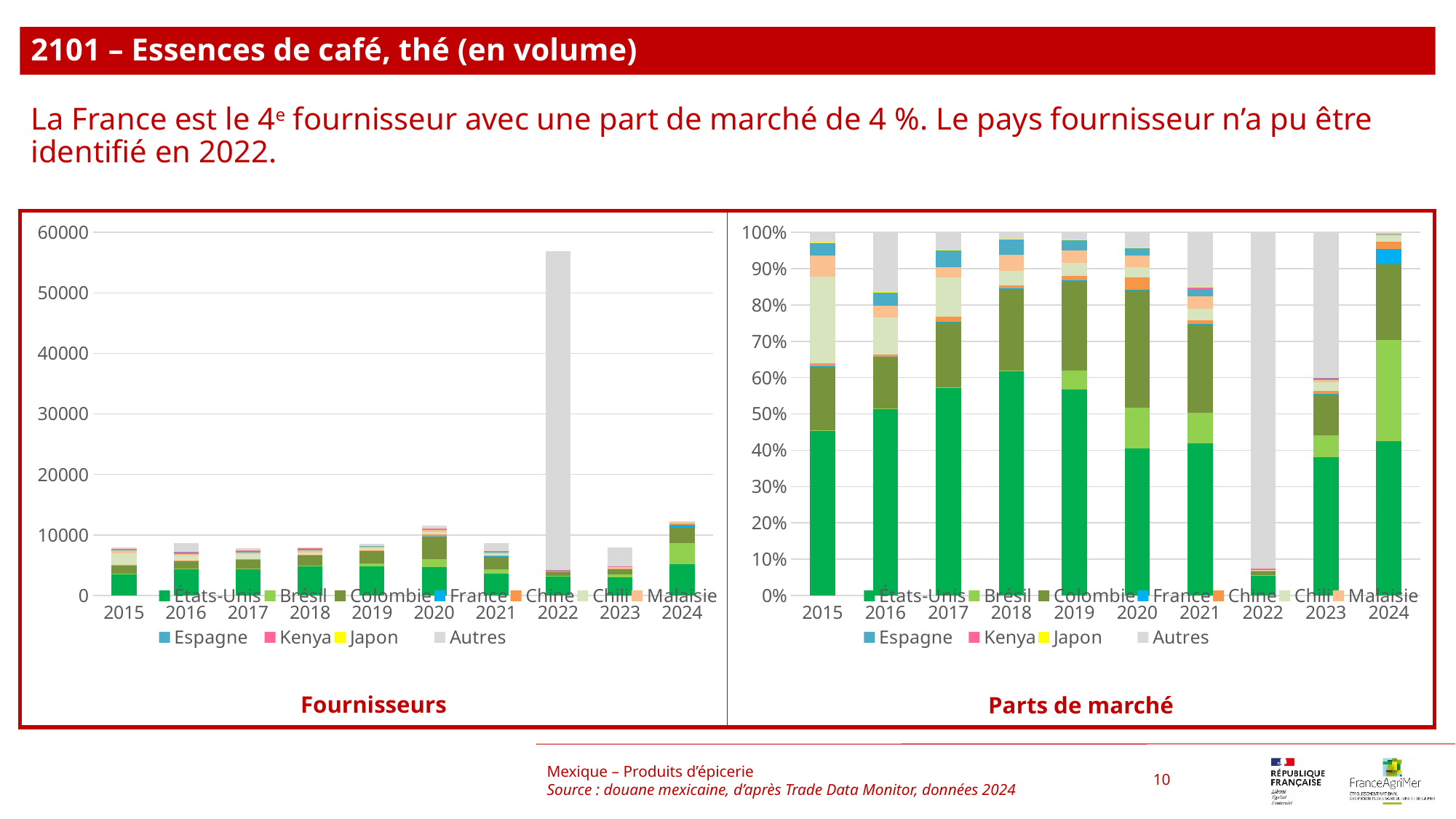
In the 'Fournisseurs' chart, is the total bar for 2024 greater or less than 10000? greater In the 'Parts de marché' chart, is the share of États-Unis in 2015 greater or less than 40%? greater In the 'Fournisseurs' chart, is the total bar for 2022 greater or less than 50000? greater In the 'Fournisseurs' chart, which total bar is taller, 2020 or 2021? 2020 How many years are shown on the x axis of the 'Parts de marché' chart? 10 What colour represents the 'Autres' series in the charts? Grey How many series does the legend of the 'Fournisseurs' chart list? 11 What kind of chart is the 'Fournisseurs' chart on the left? Stacked bar chart In the 'Fournisseurs' chart, which year has the tallest total bar? 2022 In the 'Parts de marché' chart, which series has the largest share in 2022? Autres